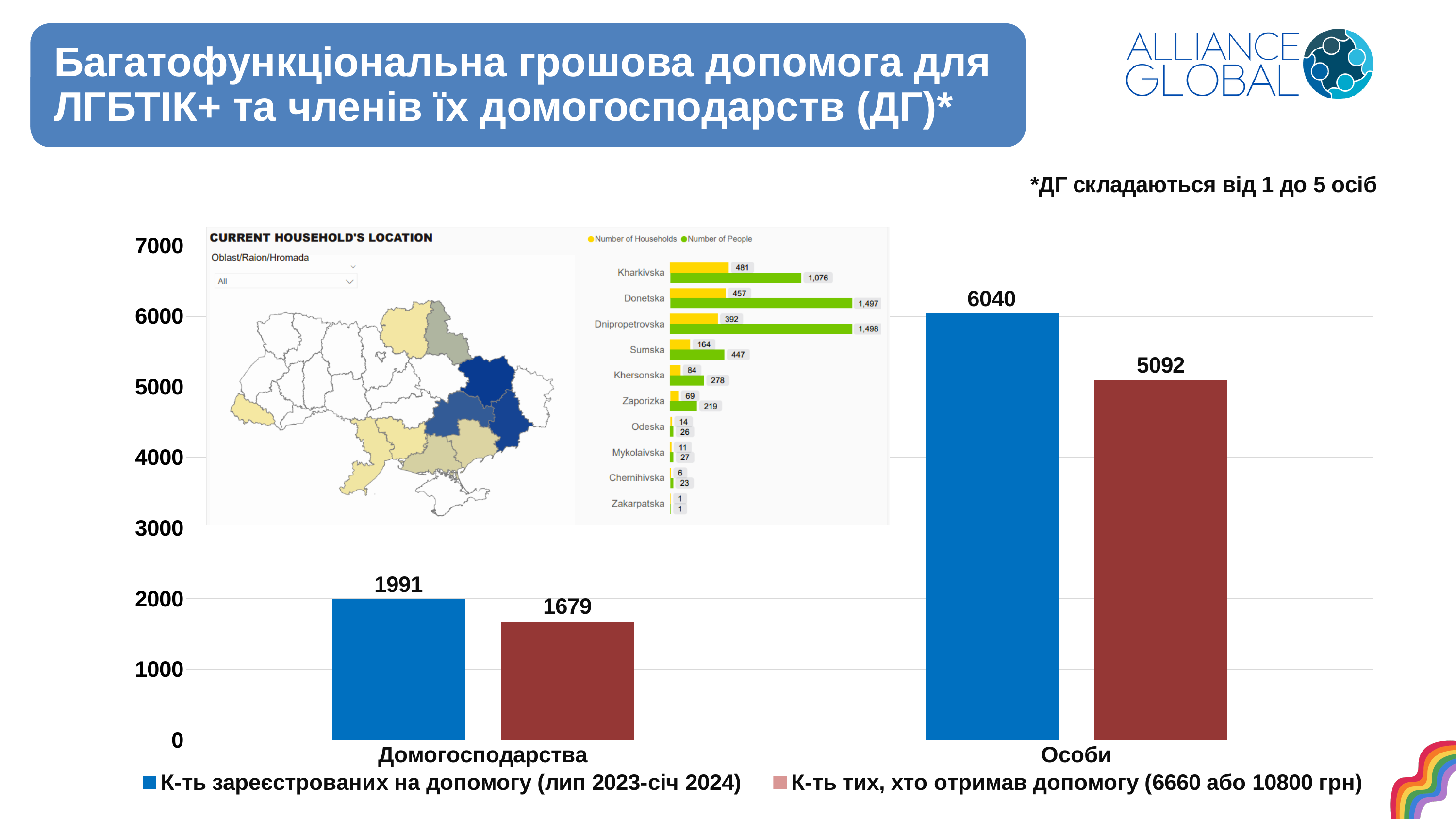
In the main bar chart, how many households received assistance (red series) in the Домогосподарства category? 1679 In the main bar chart, what is the difference between the registered and received values for Домогосподарства? 312 In the embedded 'CURRENT HOUSEHOLD'S LOCATION' chart, what is the Number of Households for Sumska? 164 How many series does the legend of the main bar chart list? 2 In the embedded 'CURRENT HOUSEHOLD'S LOCATION' chart, which oblast has the highest Number of Households? Kharkivska In the main bar chart, how many registered for assistance (blue series) in the Особи category? 6040 In the embedded 'CURRENT HOUSEHOLD'S LOCATION' chart, which oblast has the lowest Number of People? Zakarpatska How many oblasts are listed in the embedded 'CURRENT HOUSEHOLD'S LOCATION' chart? 10 In the main bar chart, what is the difference between those registered and those who received assistance in the Особи category? 948 What type of chart is the main chart on the slide? bar chart In the main bar chart, which category has the higher value for the blue series, Домогосподарства or Особи? Особи In the embedded 'CURRENT HOUSEHOLD'S LOCATION' chart, what is the Number of People for Dnipropetrovska? 1,498